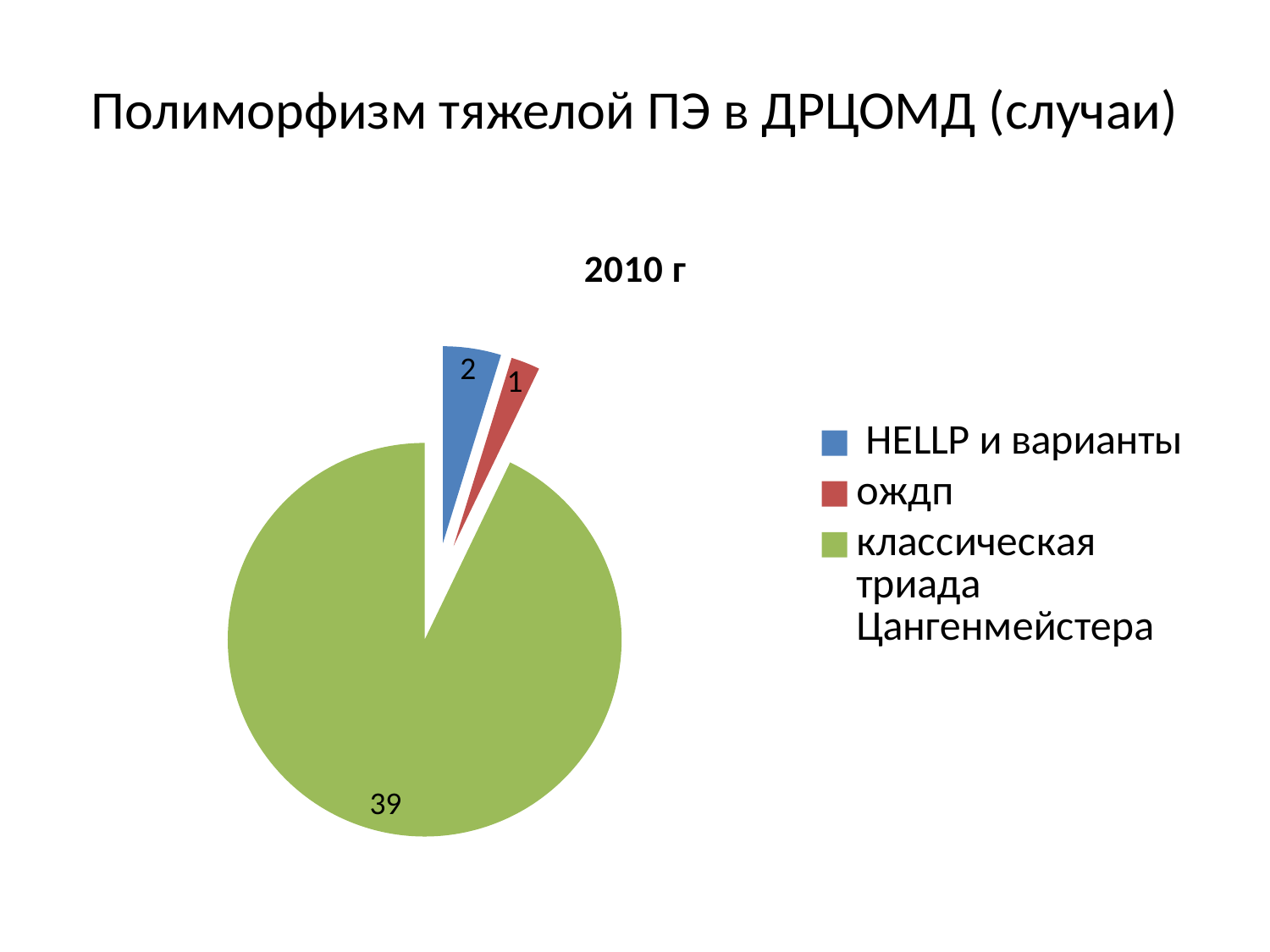
What is the value for классическая триада Цангенмейстера? 39 What is the title of the chart? 2010 г How many slices does the pie chart have? 3 What is the total of all slices in the pie chart? 42 Which is larger, the value for HELLP и варианты or the value for ождп? HELLP и варианты What type of chart is shown on the slide? pie chart What is the difference between the values for классическая триада Цангенмейстера and HELLP и варианты? 37 Which category has the smallest slice? ождп What is the value for HELLP и варианты? 2 What is the value for ождп? 1 How many entries does the legend list? 3 Which category has the largest slice? классическая триада Цангенмейстера